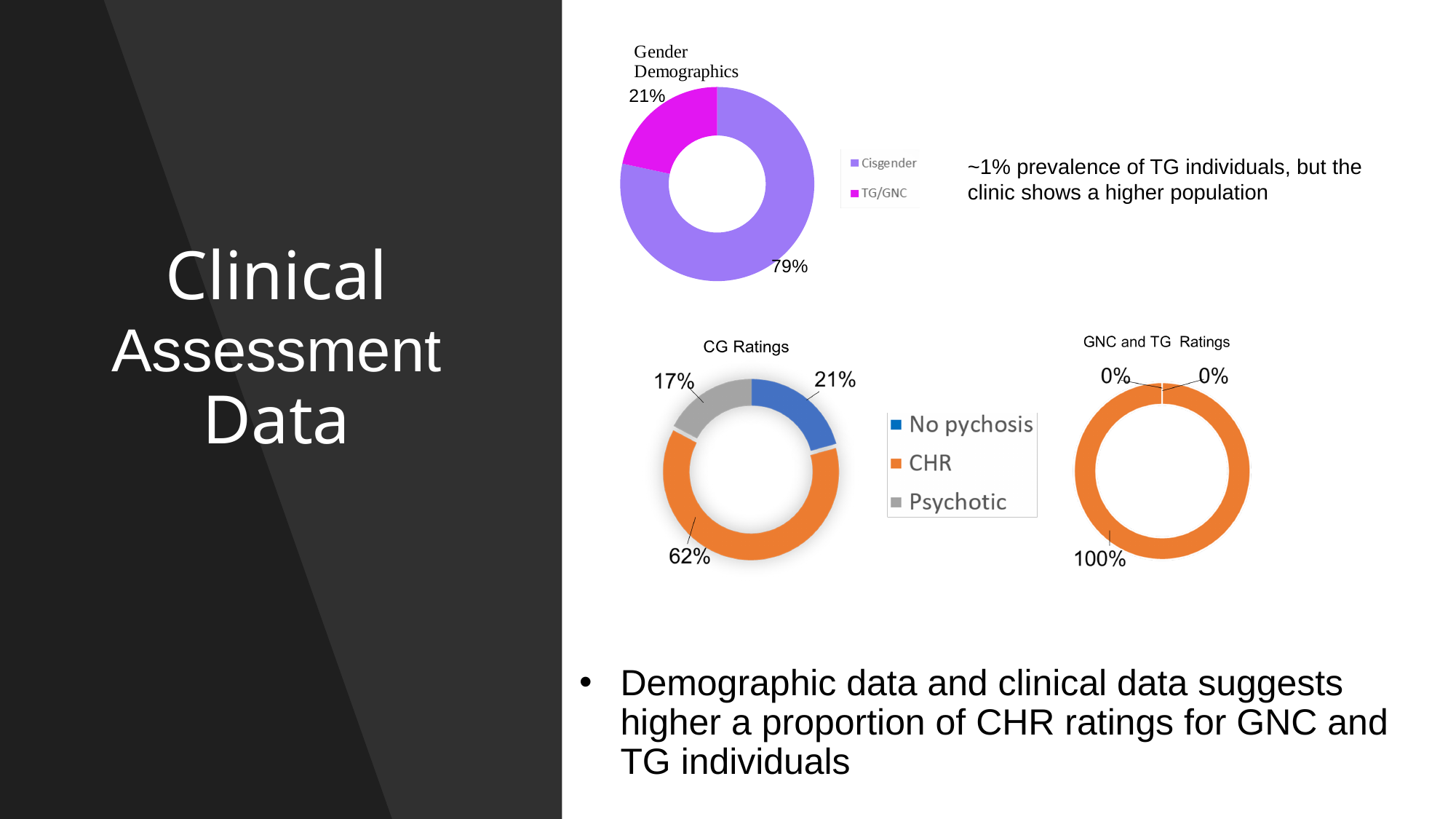
In the Gender Demographics chart, what is the difference in percentage points between Cisgender and TG/GNC? 58 In the Gender Demographics chart, what percentage is TG/GNC? 21% In the CG Ratings chart, what percentage is Psychotic? 17% In the Gender Demographics chart, which category has the larger share? Cisgender In the CG Ratings chart, what percentage is CHR? 62% In the CG Ratings chart, which is larger, No pychosis or Psychotic? No pychosis In the Gender Demographics chart, what percentage is Cisgender? 79% In the CG Ratings chart, what percentage is No pychosis? 21% In the CG Ratings chart, which category has the smallest share? Psychotic What type of chart is the Gender Demographics chart? Doughnut (pie) chart In the GNC and TG Ratings chart, what percentage is CHR? 100% How many categories does the legend for the CG Ratings chart list? 3